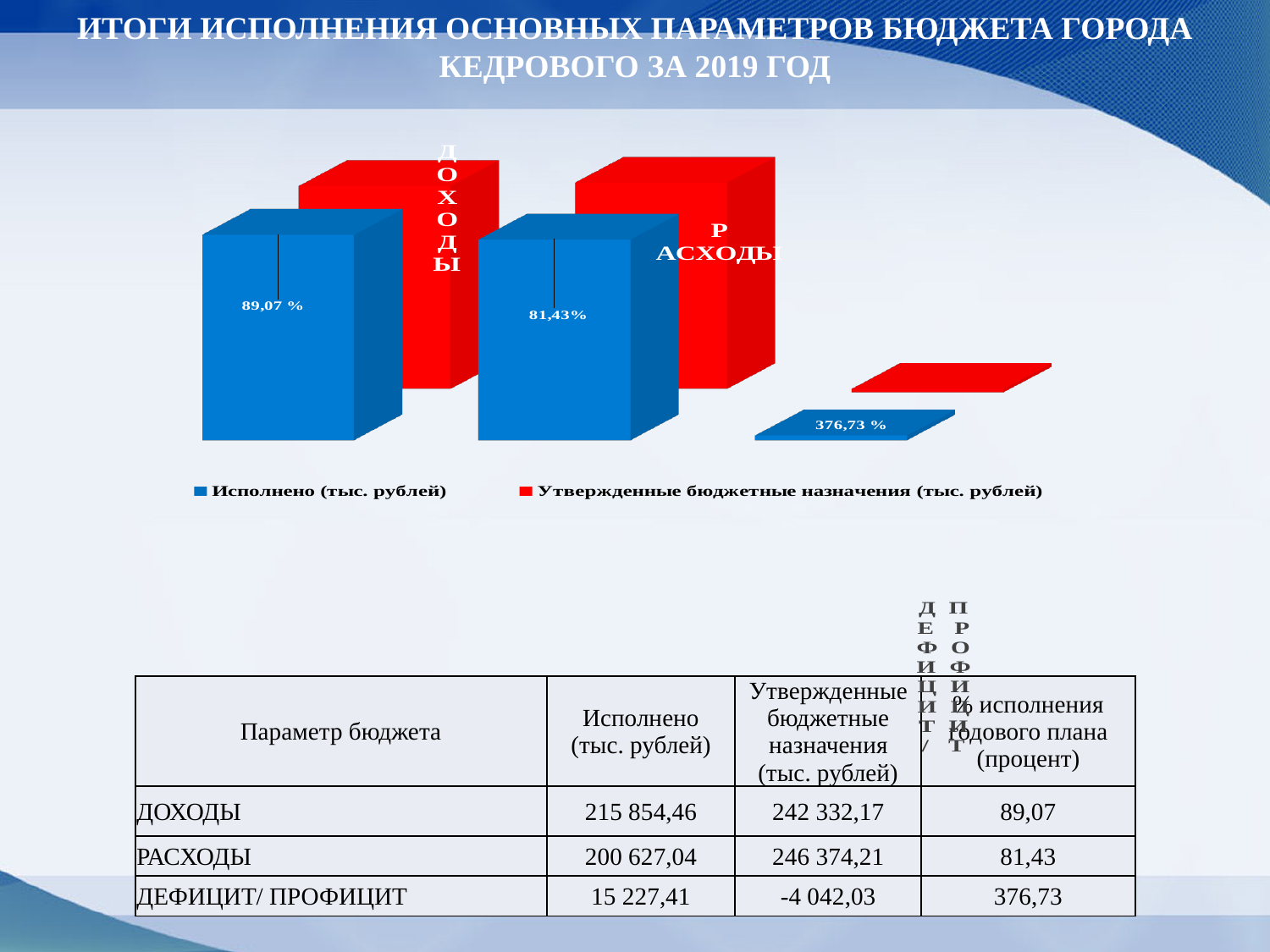
Do the blue bars rise or fall from ДОХОДЫ to ДЕФИЦИТ/ПРОФИЦИТ? fall Which category has the lowest bars in the chart? ДЕФИЦИТ/ПРОФИЦИТ What kind of chart is shown on the slide? bar chart What data label is printed on the blue bar for ДЕФИЦИТ/ПРОФИЦИТ? 376,73 % For РАСХОДЫ, which bar is taller: Исполнено or Утвержденные бюджетные назначения? Утвержденные бюджетные назначения How many series does the chart legend list? 2 What data label is printed on the blue bar for ДОХОДЫ? 89,07 % How many categories are plotted in the chart? 3 Which series is shown in red in the chart? Утвержденные бюджетные назначения (тыс. рублей) Which series is shown in blue in the chart? Исполнено (тыс. рублей) What data label is printed on the blue bar for РАСХОДЫ? 81,43%